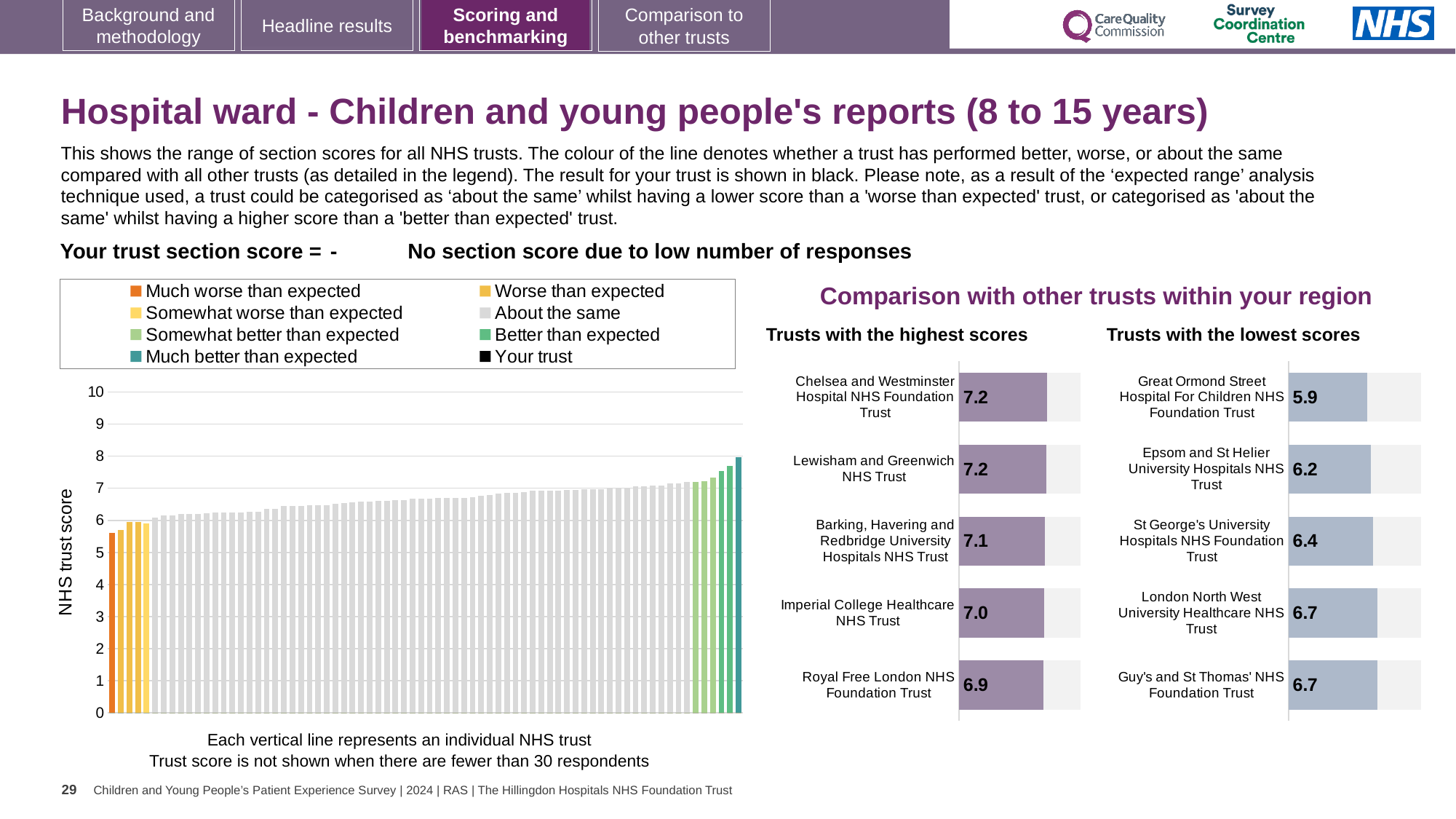
In the 'Trusts with the highest scores' chart, what is the difference between the score for Chelsea and Westminster Hospital NHS Foundation Trust and the score for Royal Free London NHS Foundation Trust? 0.3 In the large chart on the left, is the value of the leftmost (orange) bar greater or less than 6? less In the large chart on the left, do the bar values rise or fall from left to right? Rise What kind of chart is the large chart on the left showing NHS trust scores? Bar chart In the 'Trusts with the lowest scores' chart, which trust has the lowest score? Great Ormond Street Hospital For Children NHS Foundation Trust In the 'Trusts with the highest scores' chart, what is the score for Barking, Havering and Redbridge University Hospitals NHS Trust? 7.1 In the 'Trusts with the lowest scores' chart, what is the difference between the score for Guy's and St Thomas' NHS Foundation Trust and the score for Great Ormond Street Hospital For Children NHS Foundation Trust? 0.8 How many trusts are listed in the 'Trusts with the lowest scores' chart? 5 How many entries does the legend of the large chart on the left list? 8 In the 'Trusts with the lowest scores' chart, what is the score for Epsom and St Helier University Hospitals NHS Trust? 6.2 In the 'Trusts with the highest scores' chart, which trust has the lowest score shown? Royal Free London NHS Foundation Trust In the 'Trusts with the highest scores' chart, which has the higher score: Barking, Havering and Redbridge University Hospitals NHS Trust or Imperial College Healthcare NHS Trust? Barking, Havering and Redbridge University Hospitals NHS Trust